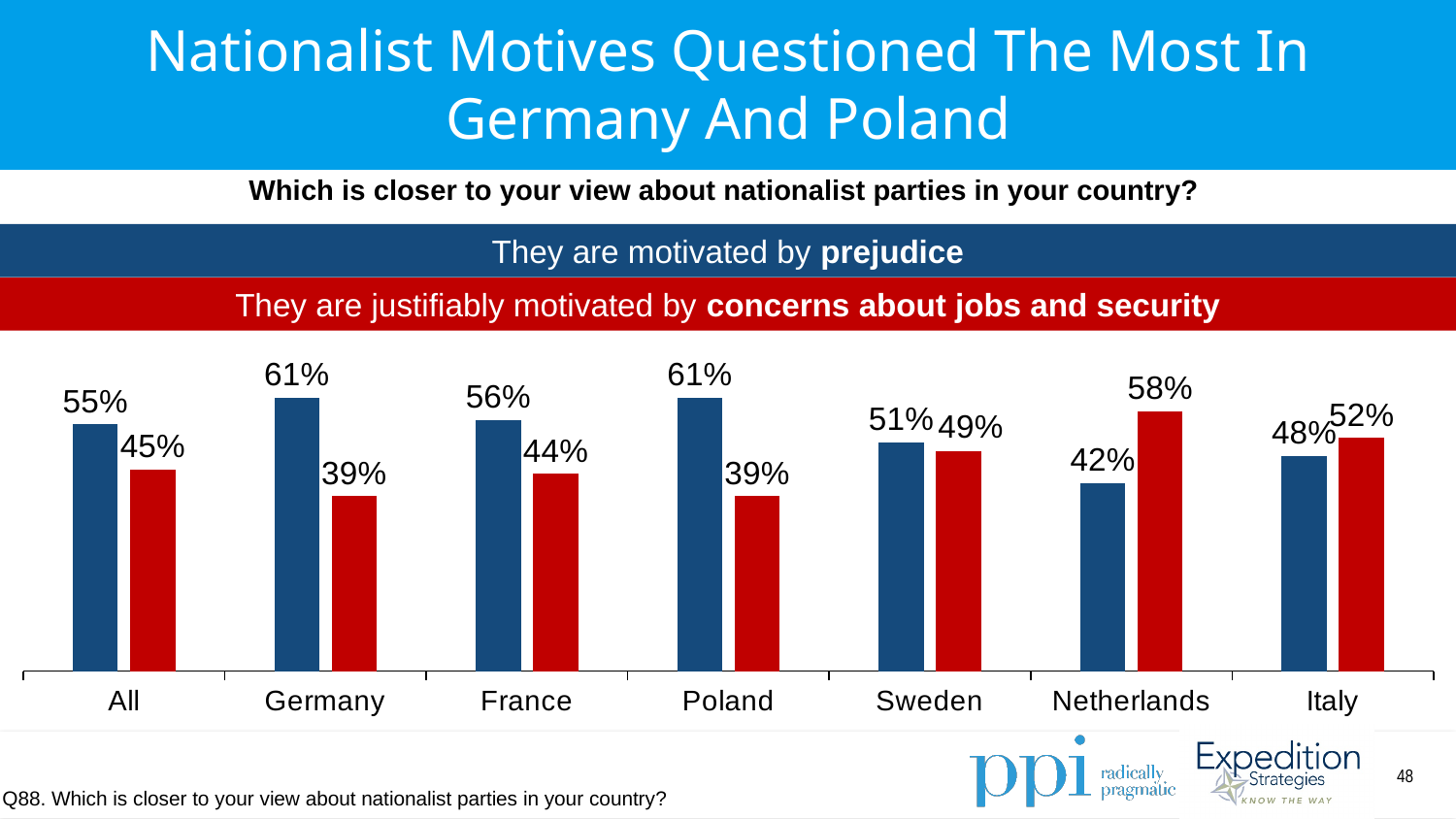
Which country has the lowest value for 'motivated by prejudice'? Netherlands How many countries or groups are shown on the x axis? 7 What is the 'concerns about jobs and security' value for France? 44% What kind of chart is shown on the slide? bar chart Which country has the highest value for 'justifiably motivated by concerns about jobs and security'? Netherlands How many series does the chart show? 2 What is the difference between the 'prejudice' and 'jobs and security' values for Poland? 22 percentage points What is the value for Sweden in the 'motivated by prejudice' series? 51% Which colour represents the 'They are motivated by prejudice' series? blue What percentage of respondents in Germany say nationalist parties are motivated by prejudice? 61% In Italy, which is larger: the 'motivated by prejudice' value or the 'concerns about jobs and security' value? concerns about jobs and security What percentage of respondents in the Netherlands say nationalist parties are justifiably motivated by concerns about jobs and security? 58%